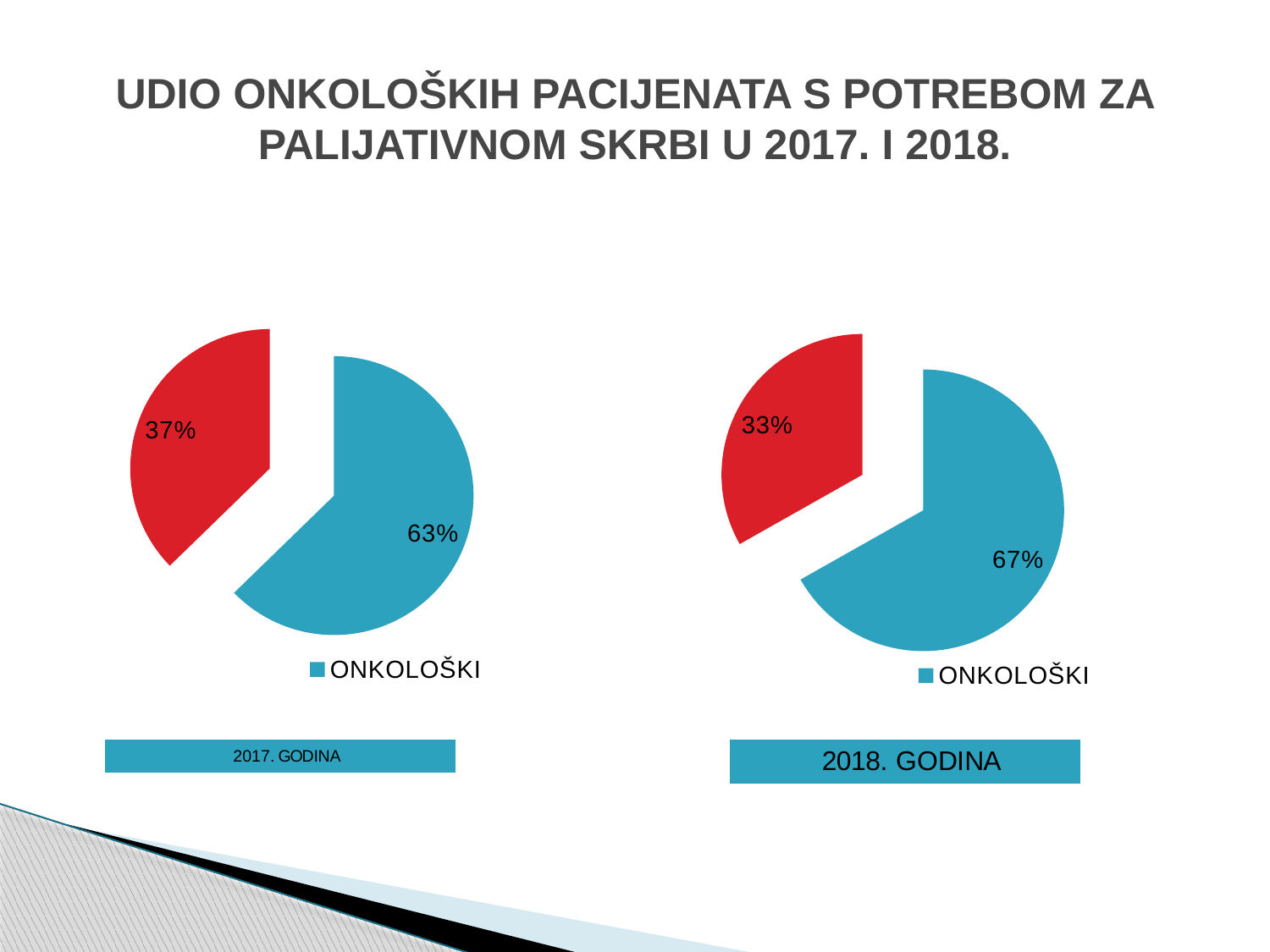
What is the legend entry shown under the 2017. GODINA pie chart? ONKOLOŠKI In the 2018. GODINA pie chart, what share is labelled for the ONKOLOŠKI slice? 67% What is the difference between the ONKOLOŠKI share in 2018. GODINA and in 2017. GODINA? 4% What colour is the ONKOLOŠKI slice in both pie charts? Blue In the 2017. GODINA pie chart, what share is labelled for the ONKOLOŠKI slice? 63% In the 2017. GODINA pie chart, which slice is larger, the blue ONKOLOŠKI slice or the red slice? The blue ONKOLOŠKI slice Which is larger: the ONKOLOŠKI share in 2017. GODINA or in 2018. GODINA? 2018. GODINA What type of chart is used for the 2017. GODINA data? Pie chart In the 2018. GODINA pie chart, what percentage is shown on the red slice? 33% How many entries does the legend of the 2018. GODINA pie chart list? 1 How many slices does the 2018. GODINA pie chart have? 2 In the 2017. GODINA pie chart, what percentage is shown on the red slice? 37%